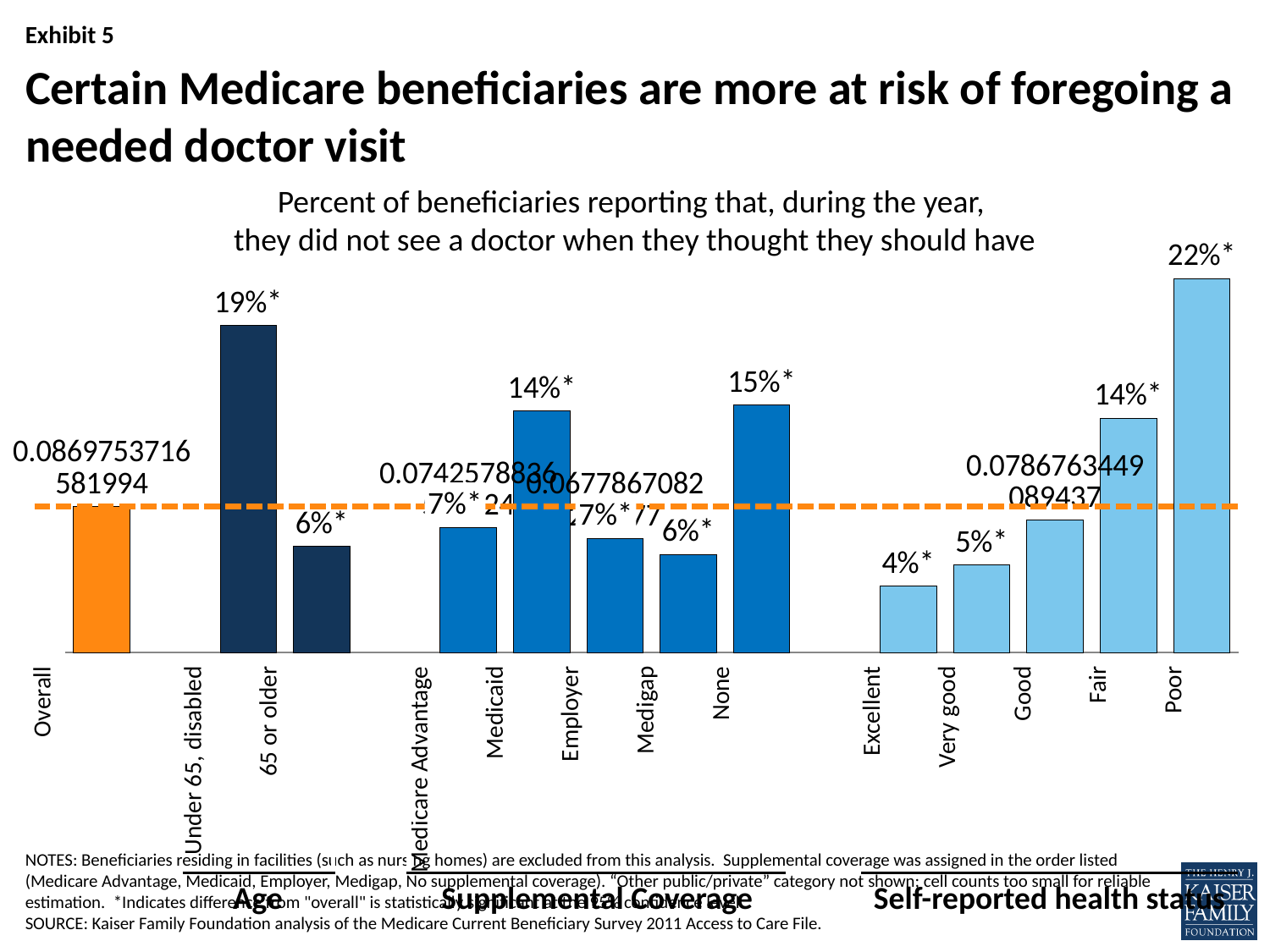
Do the values rise or fall across the self-reported health status categories from Excellent to Poor? Rise What is the value for Excellent self-reported health status? 4% What is the value for Medigap? 6% Which category has the highest percentage of beneficiaries who did not see a doctor when they thought they should have? Poor Which is larger, the value for None or the value for Medicaid? None Which category has the lowest percentage? Excellent What is the difference between the values for Fair and Very good? 9 percentage points What is the value for Under 65, disabled? 19% What kind of chart is shown on the slide? Bar chart What is the difference between the values for Poor and Excellent? 18 percentage points What is the value for Poor in the chart? 22% Which is larger, the value for Under 65, disabled or the value for 65 or older? Under 65, disabled